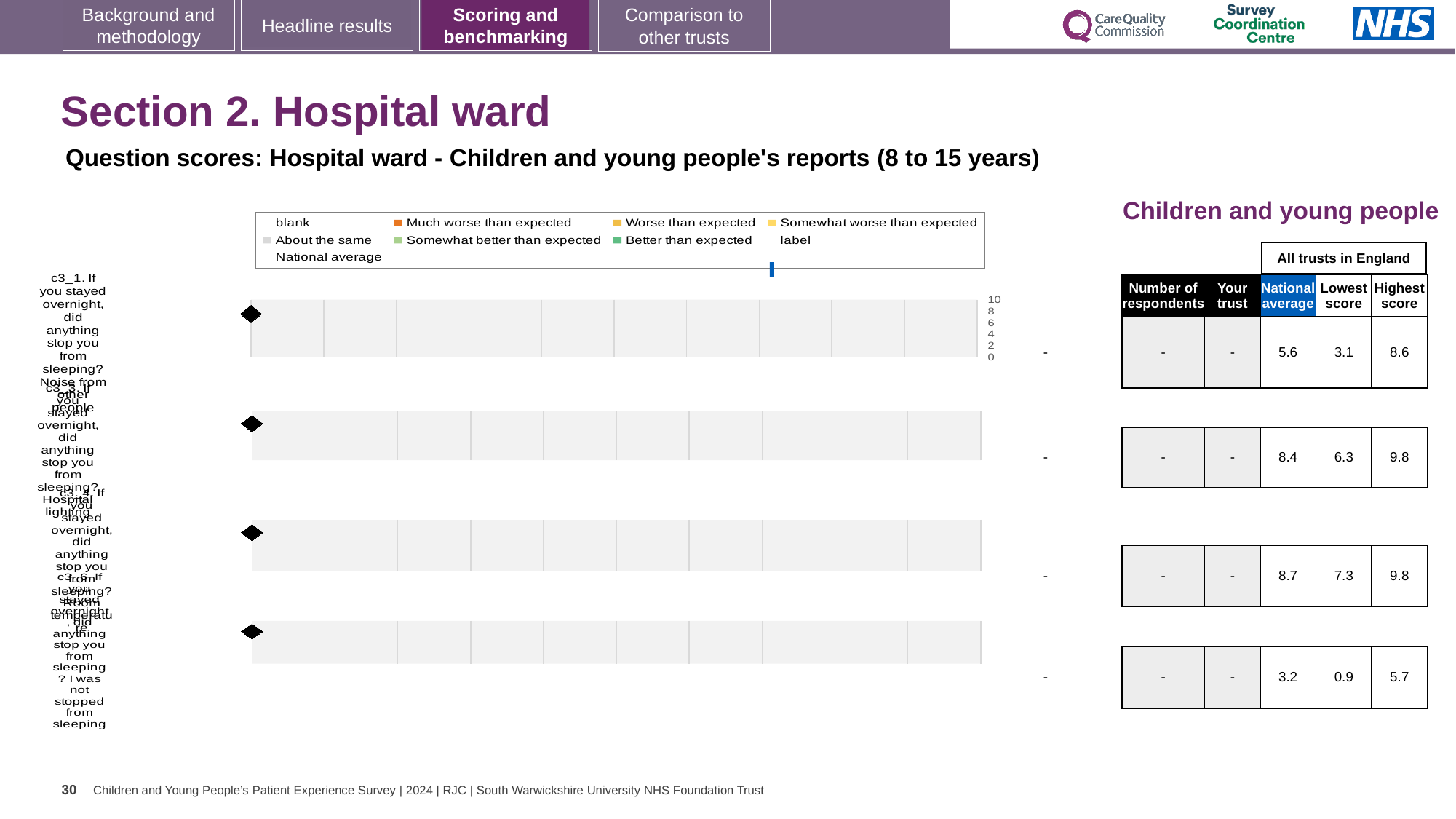
In the table next to the charts, what is the national average for the first question (c3_1, noise from other people)? 5.6 In the table, is the highest score for the first question row (8.6) larger or smaller than the highest score for the third question row (9.8)? smaller In the table next to the charts, what is the lowest score for the fourth question row (c3_6, I was not stopped from sleeping)? 0.9 In the table next to the charts, what is the highest score for the second question row? 9.8 What kind of chart is used for the question scores on this slide? bar chart Which question row in the table has the lowest national average? the fourth row (c3_6, I was not stopped from sleeping), 3.2 In the chart legend, which entry is shown with an orange marker? Much worse than expected In the table next to the charts, what is shown as the 'Your trust' score for the first question row? - Which question row in the table has the highest national average? the third row (c3_4, room temperature), 8.7 In the table, what is the difference between the highest score and the lowest score for the second question row? 3.5 How many question-score charts are shown on the slide? 4